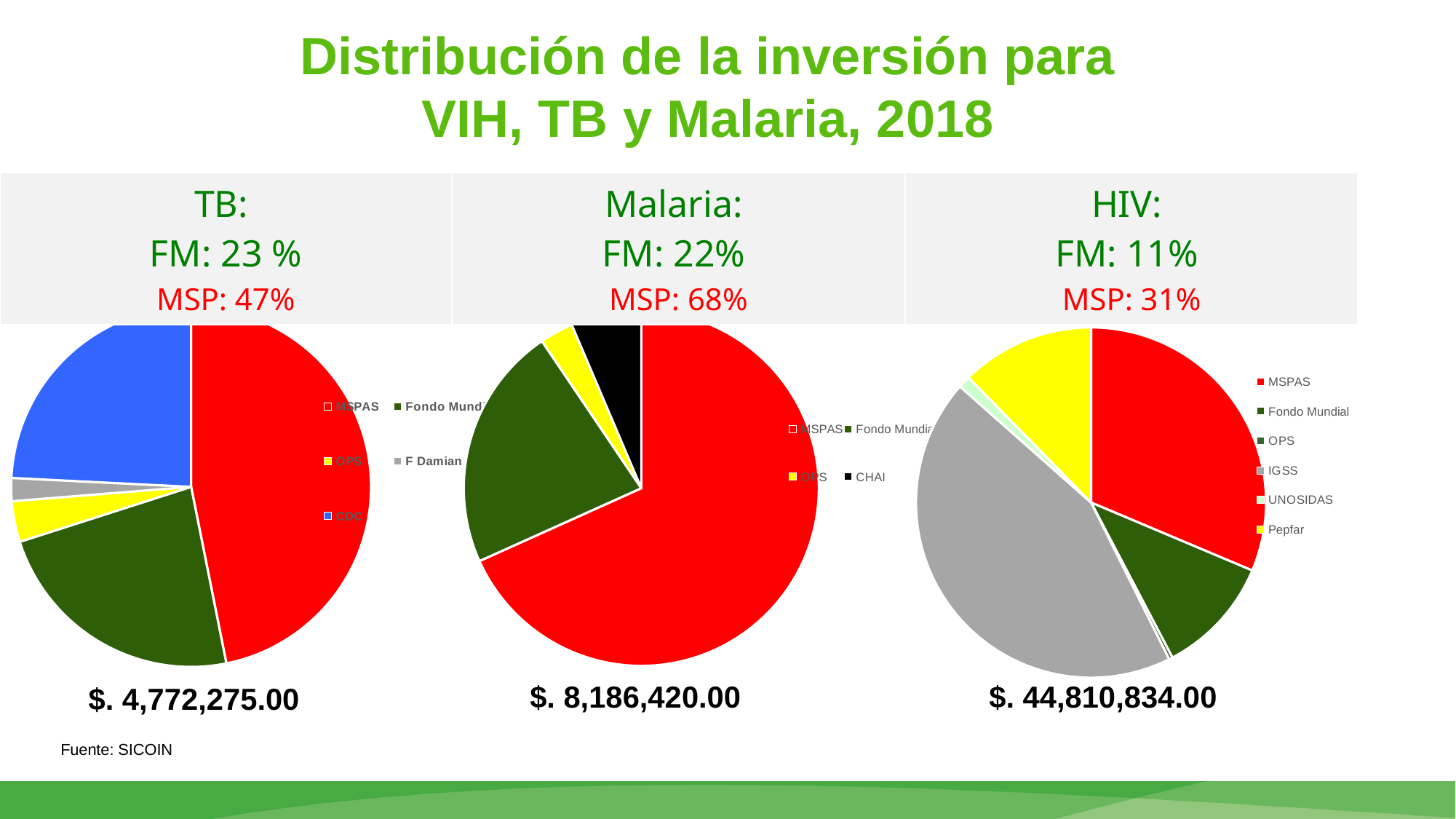
What is the total investment shown below the Malaria chart? $. 8,186,420.00 In the HIV chart, what share of the investment comes from MSP? 31% In the TB chart, how many percentage points larger is the MSP share than the FM share? 24 How many sources does the legend of the TB chart list? 5 In the Malaria chart, what share of the investment comes from FM (Fondo Mundial)? 22% What kind of charts are shown on the slide? Pie charts In the Malaria chart, which source has the smallest slice? OPS In the TB chart, what share of the investment comes from MSP? 47% How many sources does the legend of the HIV chart list? 6 What is the total investment shown below the HIV chart? $. 44,810,834.00 In the Malaria chart, how many percentage points larger is the MSP share than the FM share? 46 In the HIV chart, which source has the largest slice? IGSS